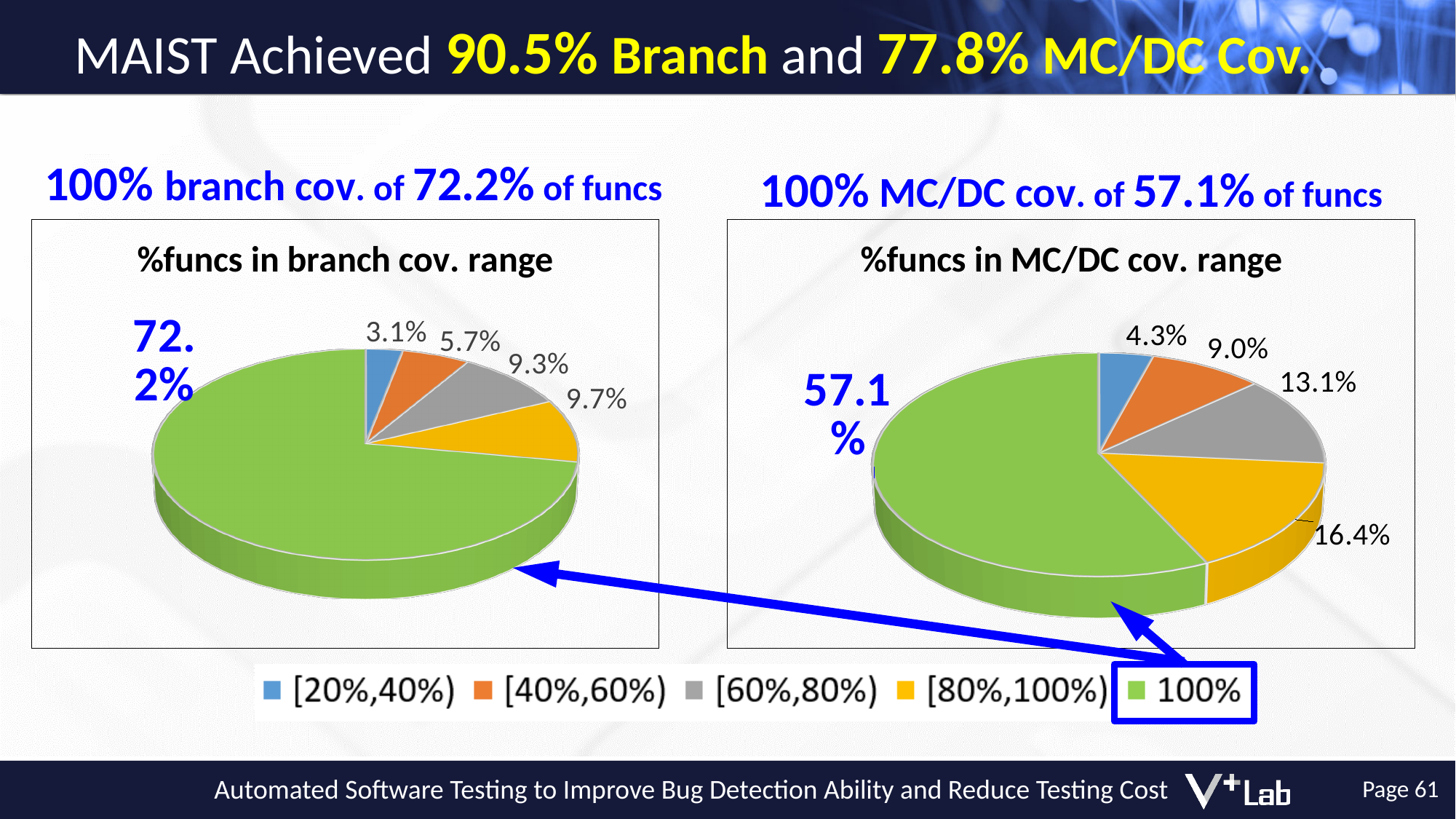
How many entries does the shared legend list? 5 In the '%funcs in MC/DC cov. range' chart, which coverage range has the largest share? 100% In the '%funcs in MC/DC cov. range' chart, what is the value for the [80%,100%) range? 16.4% In the '%funcs in branch cov. range' chart, which coverage range has the smallest share? [20%,40%) In the '%funcs in MC/DC cov. range' chart, what is the value for the [60%,80%) range? 13.1% In the '%funcs in branch cov. range' chart, what share of functions have 100% branch coverage? 72.2% In the '%funcs in branch cov. range' chart, which is larger: the [60%,80%) slice or the [40%,60%) slice? [60%,80%) In the '%funcs in MC/DC cov. range' chart, what share of functions have 100% MC/DC coverage? 57.1% What type of chart is '%funcs in MC/DC cov. range'? Pie chart What colour represents the 100% coverage range in the legend? Green What is the difference between the 100% slice in the branch coverage chart and the 100% slice in the MC/DC coverage chart? 15.1% In the '%funcs in branch cov. range' chart, what is the value for the [20%,40%) range? 3.1%